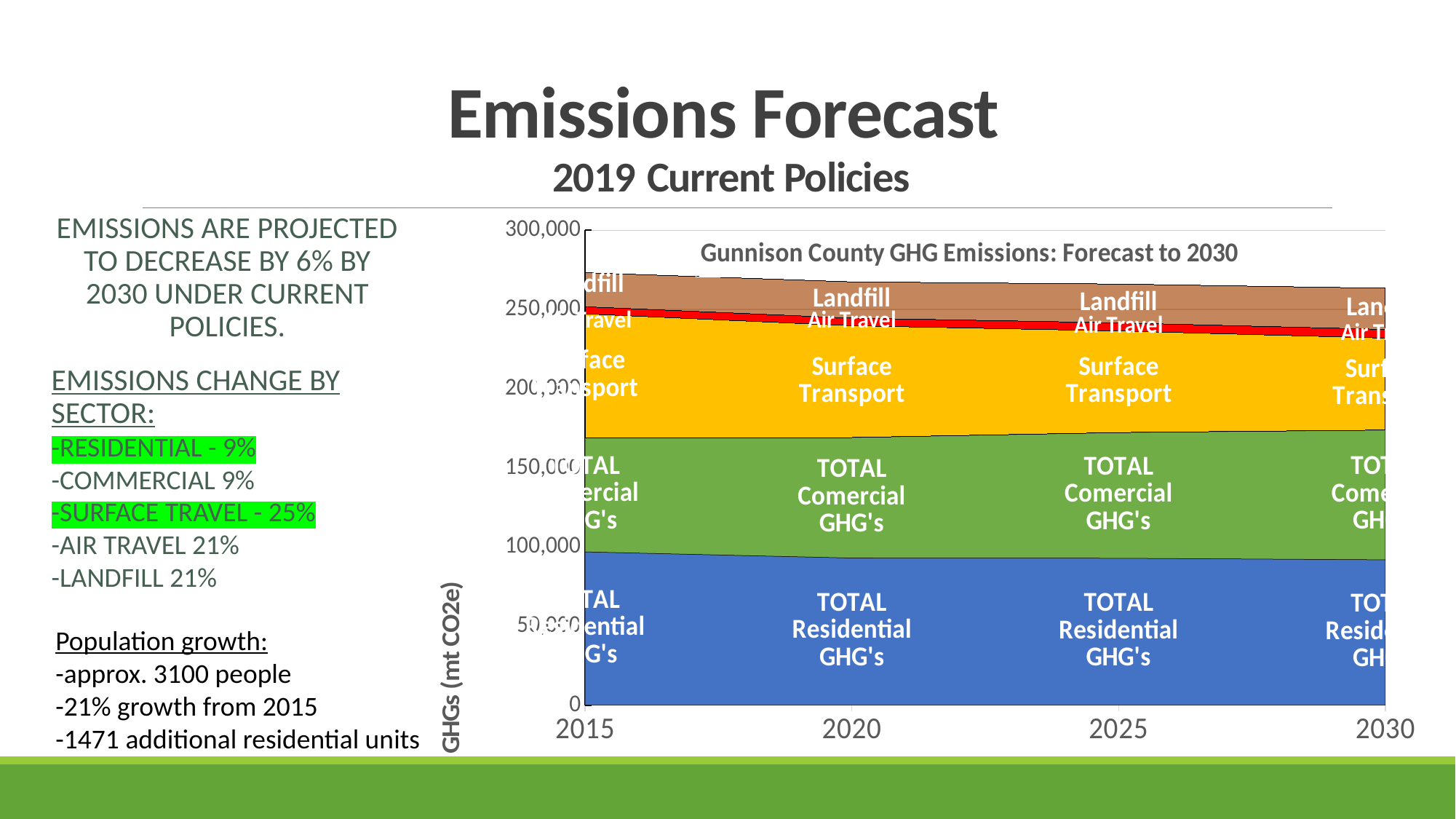
What type of chart is shown on the slide? Stacked area chart Is the cumulative top of the TOTAL Comercial GHG's band in 2015 greater or less than 150,000? greater How many sectors are stacked in the chart? 5 Which sector has the thickest band in the chart? TOTAL Residential GHG's Does the total stacked emissions value rise or fall from 2015 to 2030? Fall Is the total stacked emissions value in 2015 greater or less than 250,000? greater What is the title of the chart? Gunnison County GHG Emissions: Forecast to 2030 Which sector has the thinnest band in the chart? Air Travel Which band is larger in 2015, TOTAL Residential GHG's or Landfill? TOTAL Residential GHG's What is the label of the y axis? GHGs (mt CO2e) How many years are labelled on the x axis of the chart? 4